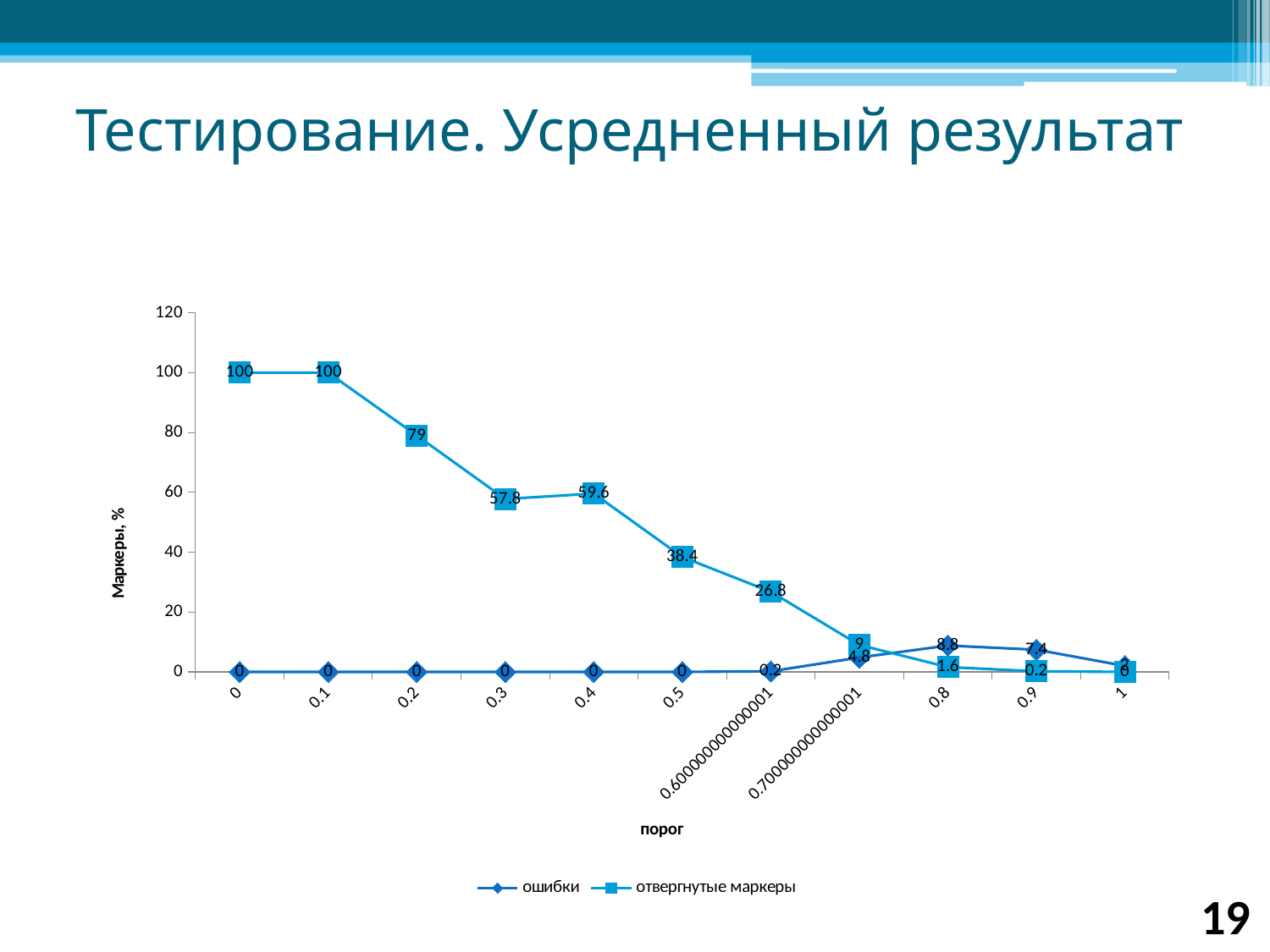
What is the difference between the отвергнутые маркеры values at порог 0.1 and порог 0.2? 21 What is the value of отвергнутые маркеры at порог 0.2? 79 What is the value of отвергнутые маркеры at порог 0.5? 38.4 What kind of chart is shown on the slide? line chart How many порог values are plotted along the x axis? 11 What is the value of ошибки at порог 0.8? 8.8 What is the title of the vertical axis? Маркеры, % At which порог value does the ошибки series reach its highest value? 0.8 Does the отвергнутые маркеры series generally rise or fall as порог increases? fall What is the value of отвергнутые маркеры at порог 0.3? 57.8 At порог 0.8, which series has the larger value, ошибки or отвергнутые маркеры? ошибки How many series does the legend list? 2